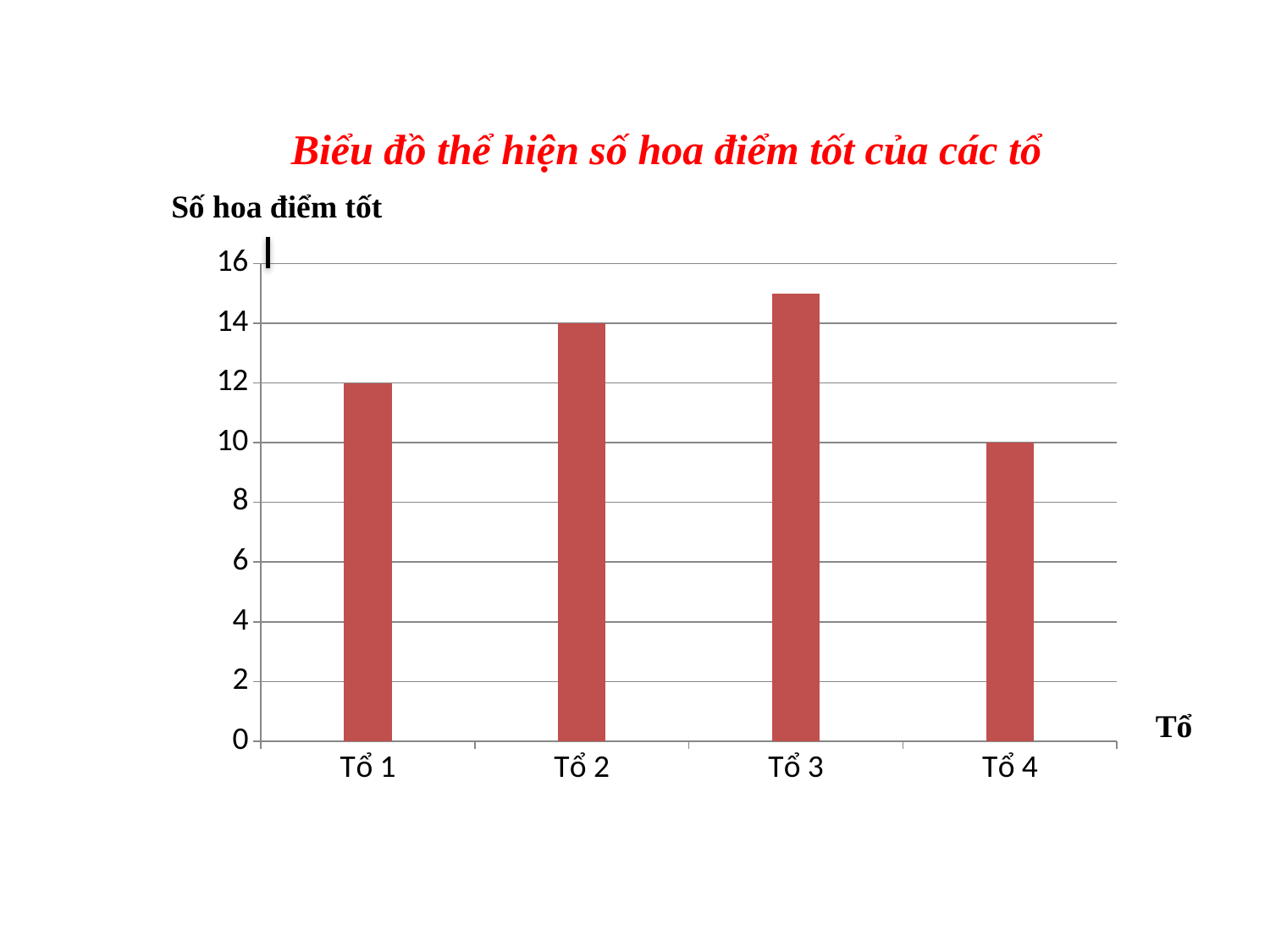
Which tổ has the lowest number of hoa điểm tốt? Tổ 4 Is the value for Tổ 3 greater or less than 14? greater Which tổ has the highest number of hoa điểm tốt? Tổ 3 What is the value for Tổ 1? 12 What kind of chart is shown on the slide? bar chart What is the difference between the values for Tổ 1 and Tổ 4? 2 How many tổ (categories) are shown on the chart? 4 What is the value for Tổ 2? 14 What is the title of the chart? Biểu đồ thể hiện số hoa điểm tốt của các tổ What is the difference between the values for Tổ 2 and Tổ 4? 4 Which is larger, the value for Tổ 1 or the value for Tổ 2? Tổ 2 What is the value for Tổ 4? 10